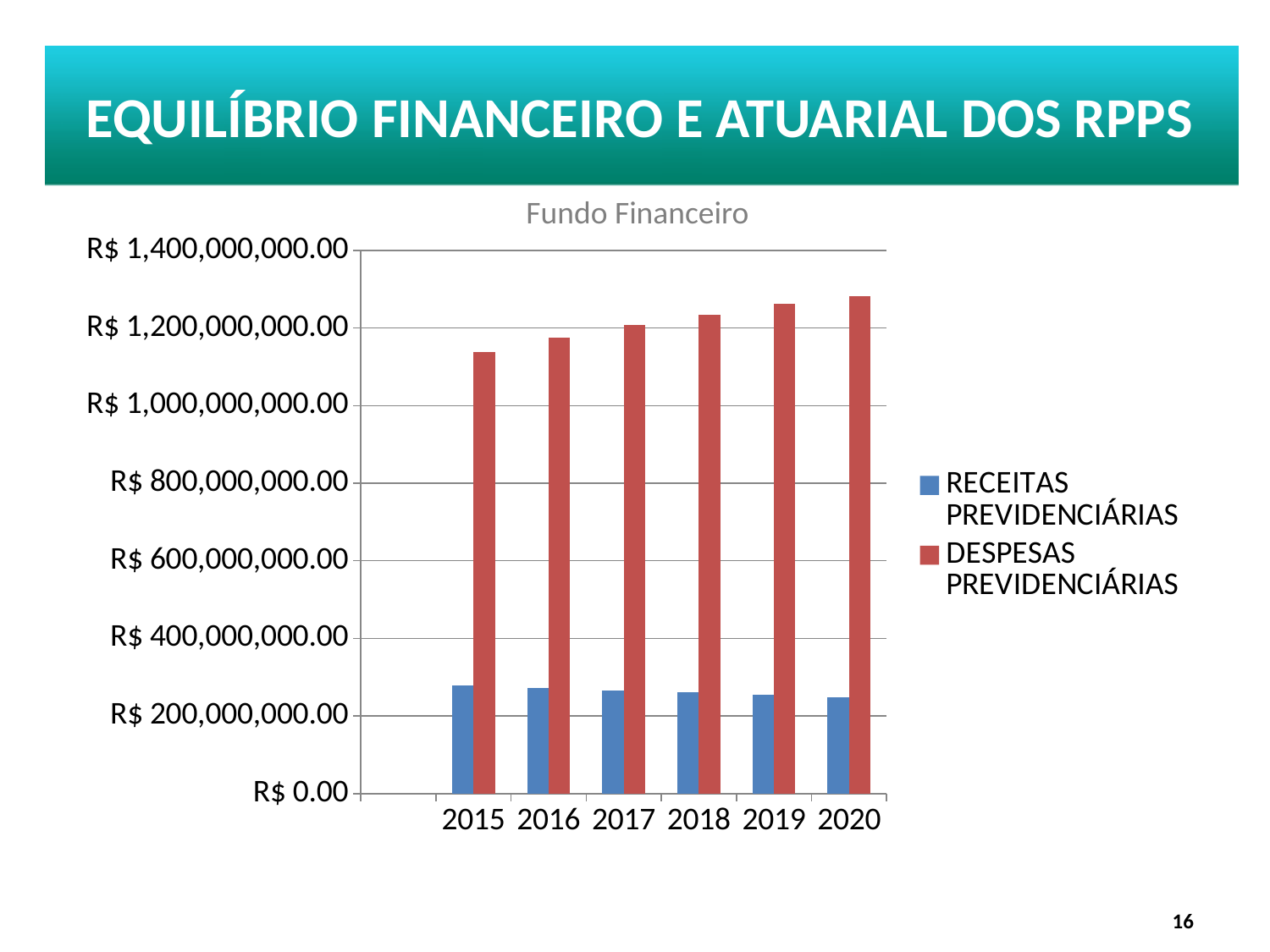
In which year are DESPESAS PREVIDENCIÁRIAS lowest? 2015 Is the value for DESPESAS PREVIDENCIÁRIAS in 2020 greater or less than R$ 1,400,000,000.00? less What kind of chart is shown on the slide? bar chart How many series does the legend list? 2 In which year are DESPESAS PREVIDENCIÁRIAS highest? 2020 Is the value for RECEITAS PREVIDENCIÁRIAS in 2015 greater or less than R$ 400,000,000.00? less How many years are shown on the x axis? 6 Is the value for DESPESAS PREVIDENCIÁRIAS in 2015 greater or less than R$ 1,000,000,000.00? greater What is the title of the chart? Fundo Financeiro Which is larger in 2018, RECEITAS PREVIDENCIÁRIAS or DESPESAS PREVIDENCIÁRIAS? DESPESAS PREVIDENCIÁRIAS Which series is shown in red? DESPESAS PREVIDENCIÁRIAS Do DESPESAS PREVIDENCIÁRIAS rise or fall from 2015 to 2020? rise